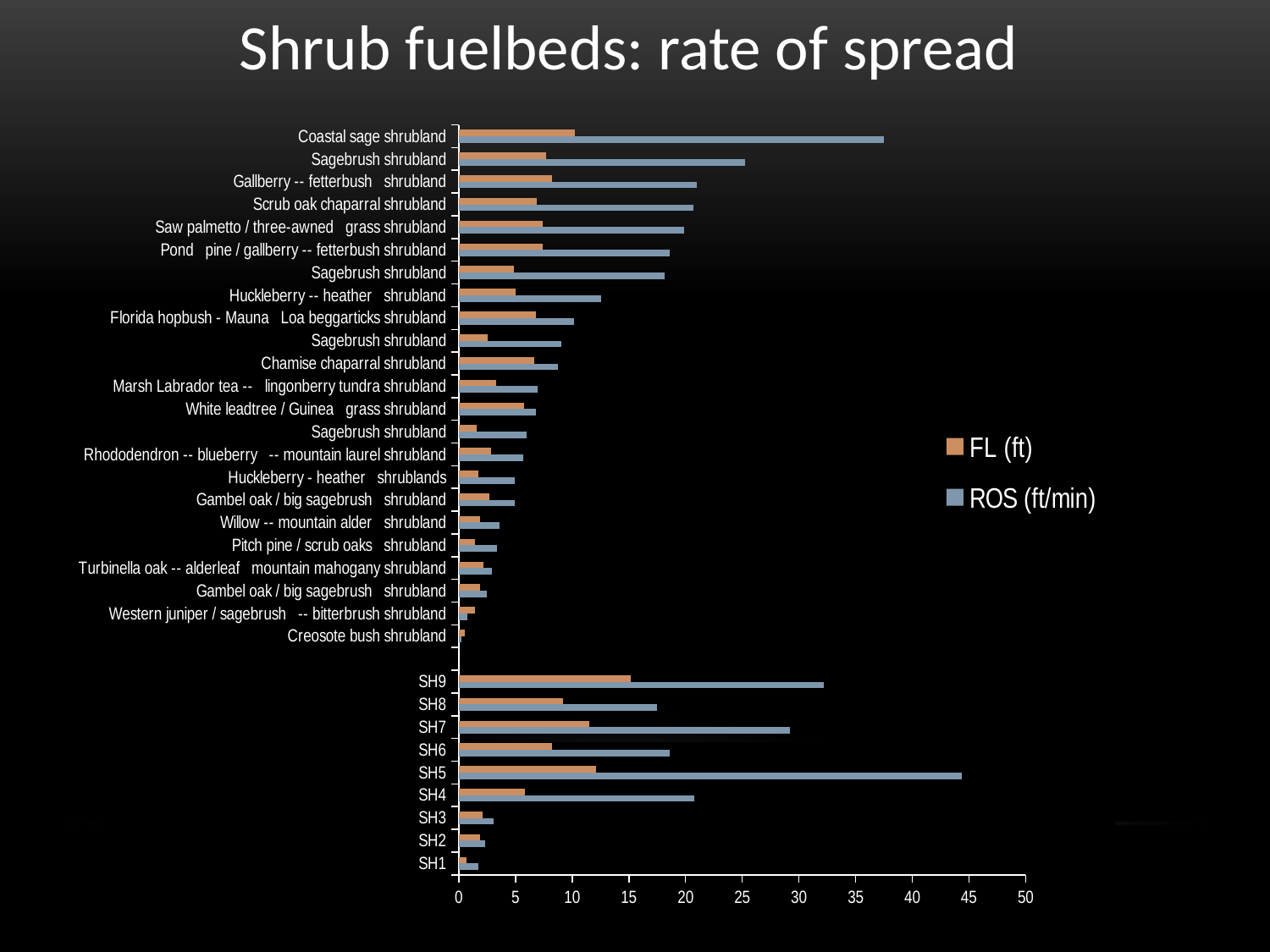
Is the FL (ft) value for SH9 greater or less than 10? greater What is the title of the slide? Shrub fuelbeds: rate of spread How many series does the legend list? 2 Is the ROS (ft/min) value for Coastal sage shrubland greater or less than 35? greater What are the two series named in the legend? FL (ft) and ROS (ft/min) Which has the larger ROS (ft/min) value, SH9 or SH8? SH9 How many SH-numbered categories (SH1 to SH9) are plotted? 9 Which has the larger ROS (ft/min) value, Coastal sage shrubland or Scrub oak chaparral shrubland? Coastal sage shrubland Is the ROS (ft/min) value for SH5 greater or less than 40? greater Which category has the highest ROS (ft/min) value? SH5 What kind of chart is shown on the slide? bar chart